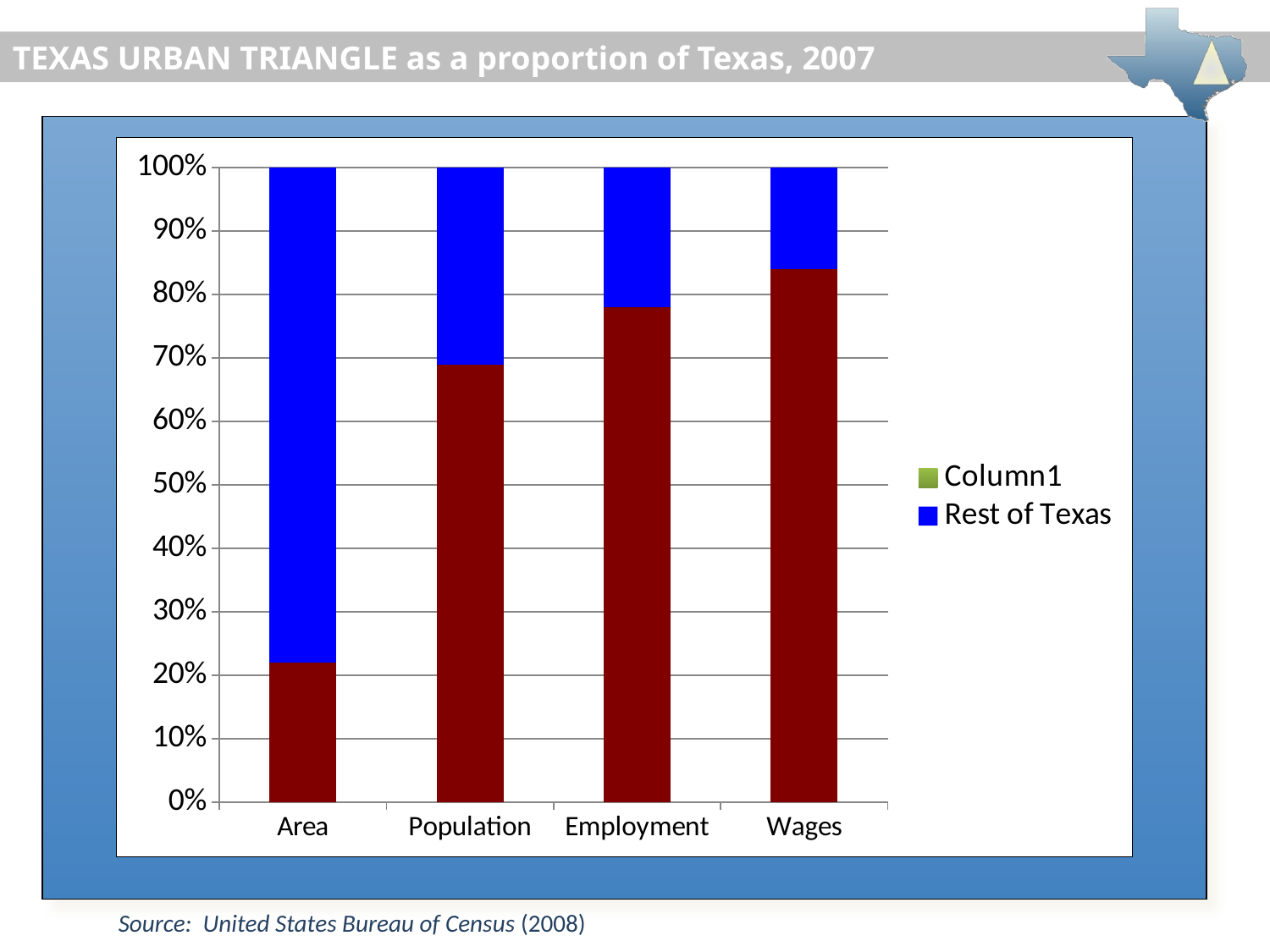
How many series does the chart's legend list? 2 Is the dark red segment for Population greater or less than 60%? greater Does the dark red segment rise or fall moving from Area to Wages along the x axis? Rise How many categories are shown on the x axis of the chart? 4 Which has the larger dark red segment, Population or Employment? Employment Which category has the shortest dark red segment? Area Is the dark red segment for Employment greater or less than 70%? greater Is the dark red segment for Area greater or less than 30%? less What kind of chart is shown on the slide? Stacked bar chart Which category has the tallest dark red segment? Wages Which category has the largest blue 'Rest of Texas' segment? Area